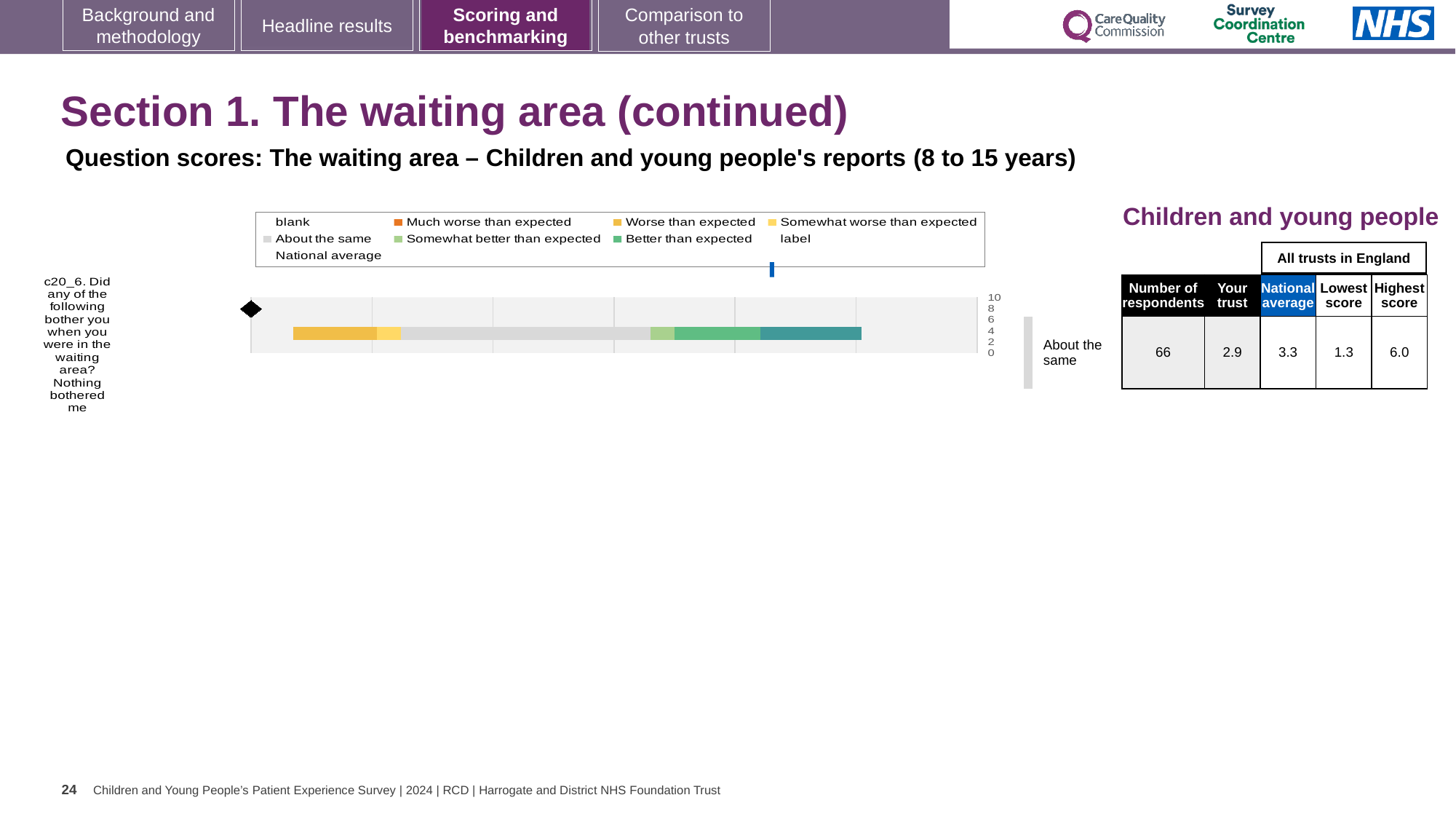
What is the 'Your trust' score for question c20_6 (Nothing bothered me in the waiting area)? 2.9 Which is larger for question c20_6: the trust's score or the national average? National average What is the lowest score among all trusts in England for question c20_6? 1.3 How many survey questions are plotted in the chart on this slide? 1 How many respondents answered question c20_6? 66 What benchmark category is the trust's result for question c20_6 labelled as on the chart? About the same What is the national average score for question c20_6? 3.3 What is the highest score among all trusts in England for question c20_6? 6.0 What is the difference between the national average and the trust's score for question c20_6? 0.4 What is the difference between the highest score and the lowest score for question c20_6? 4.7 Which legend entry in the chart is shown in dark teal? Better than expected What kind of chart is shown on the slide for question c20_6? bar chart